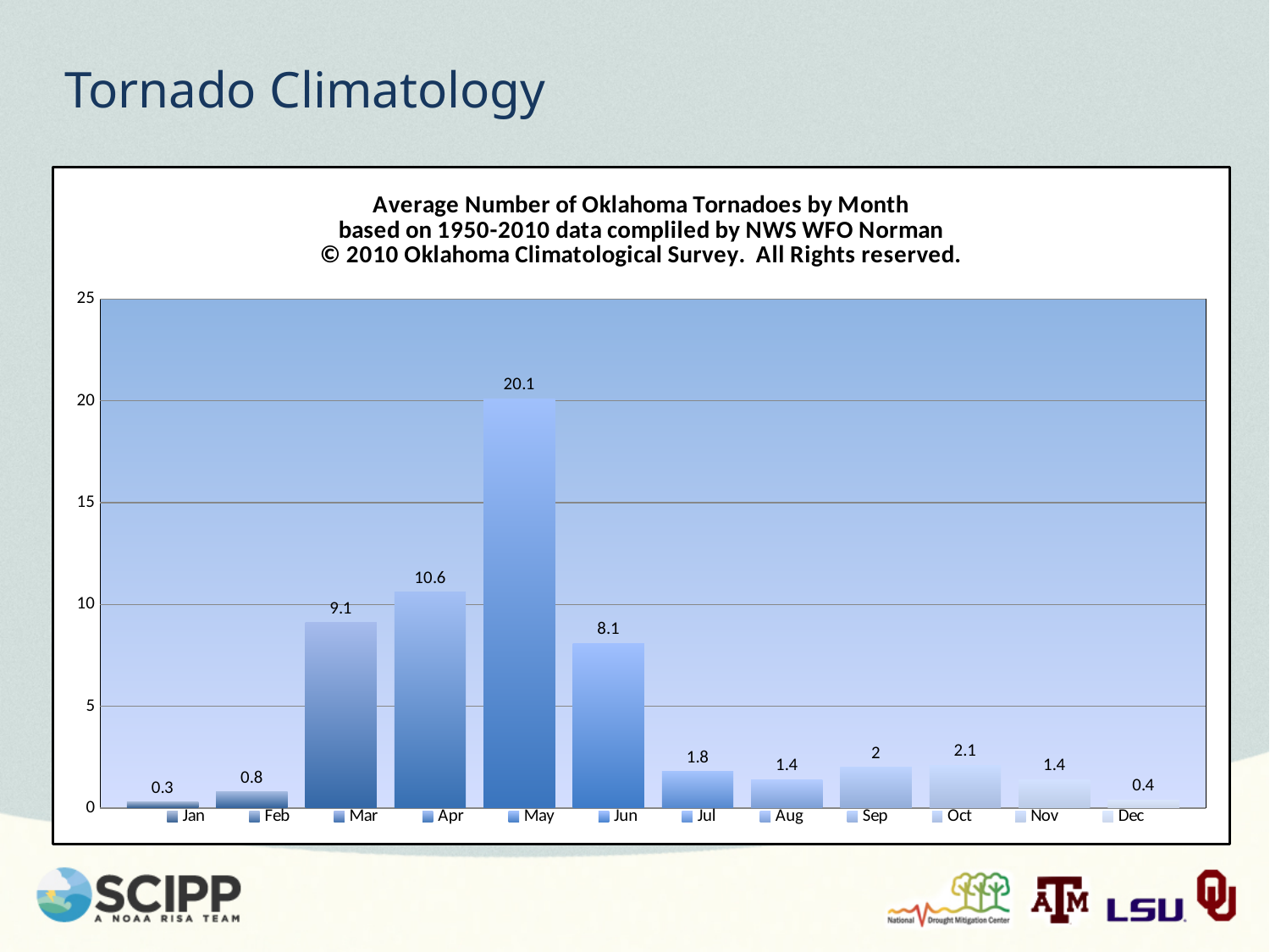
Which month has the lowest average number of tornadoes? Jan What is the difference between the average number of tornadoes in May and in April? 9.5 What kind of chart is shown on the slide? Bar chart What is the difference between the average number of tornadoes in June and in July? 6.3 Is the value for May greater or less than 15? greater Which month has the highest average number of tornadoes? May How many months are shown on the x axis of the chart? 12 What is the maximum value shown on the vertical axis of the chart? 25 What is the average number of Oklahoma tornadoes in May? 20.1 Which month has a higher average number of tornadoes, April or June? Apr What is the average number of Oklahoma tornadoes in October? 2.1 What is the average number of Oklahoma tornadoes in March? 9.1